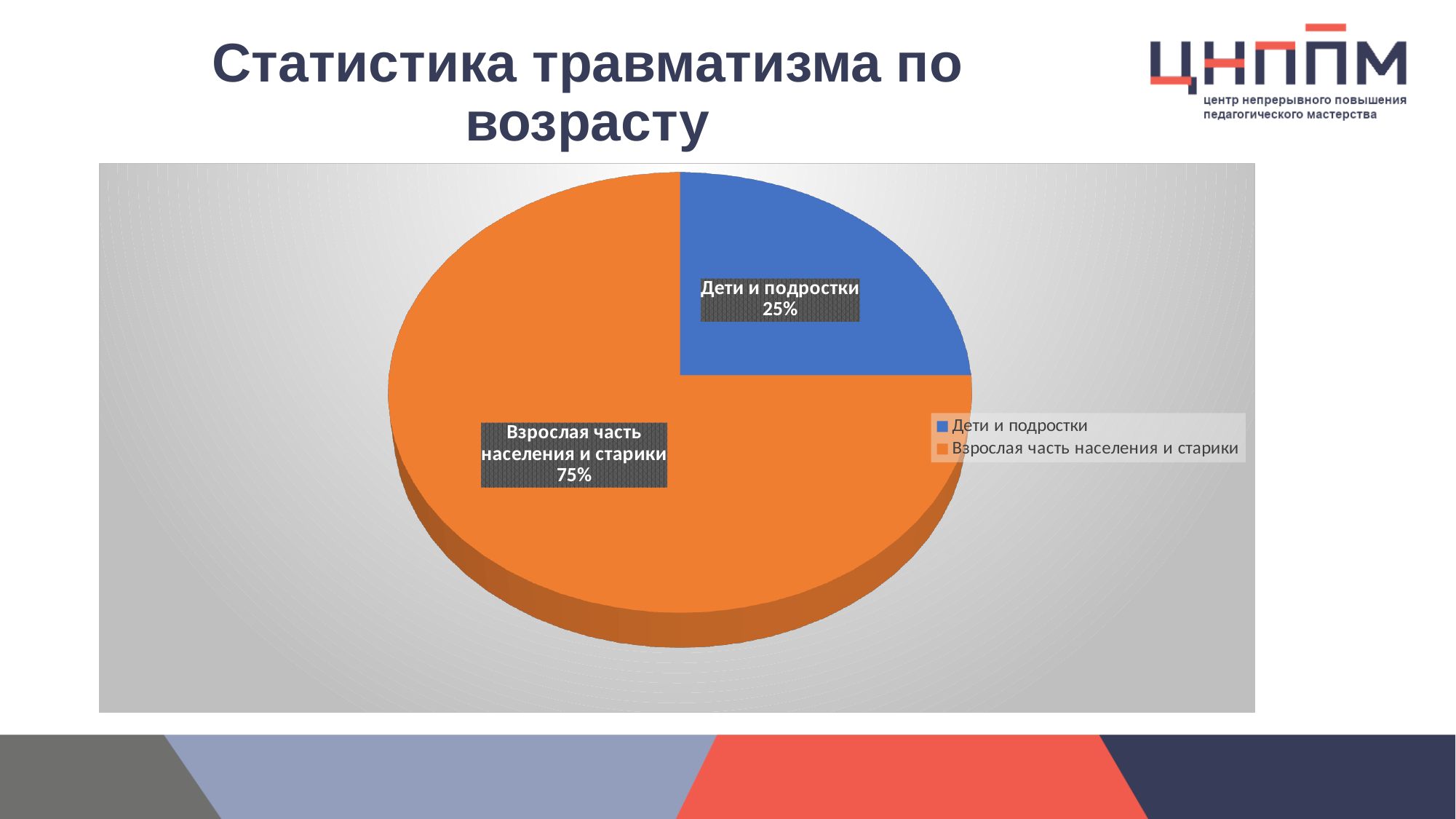
How many categories are shown in the pie chart? 2 What share of the pie does "Дети и подростки" represent? 25% What is the difference in percentage points between the "Взрослая часть населения и старики" slice and the "Дети и подростки" slice? 50% Which category has the smallest slice of the pie? Дети и подростки Which category has the largest slice of the pie? Взрослая часть населения и старики What is the title of the slide containing the chart? Статистика травматизма по возрасту What kind of chart is shown on the slide? Pie chart What share of the pie does "Взрослая часть населения и старики" represent? 75% Which slice is larger: "Дети и подростки" or "Взрослая часть населения и старики"? Взрослая часть населения и старики What colour is the "Дети и подростки" slice? Blue How many entries does the legend list? 2